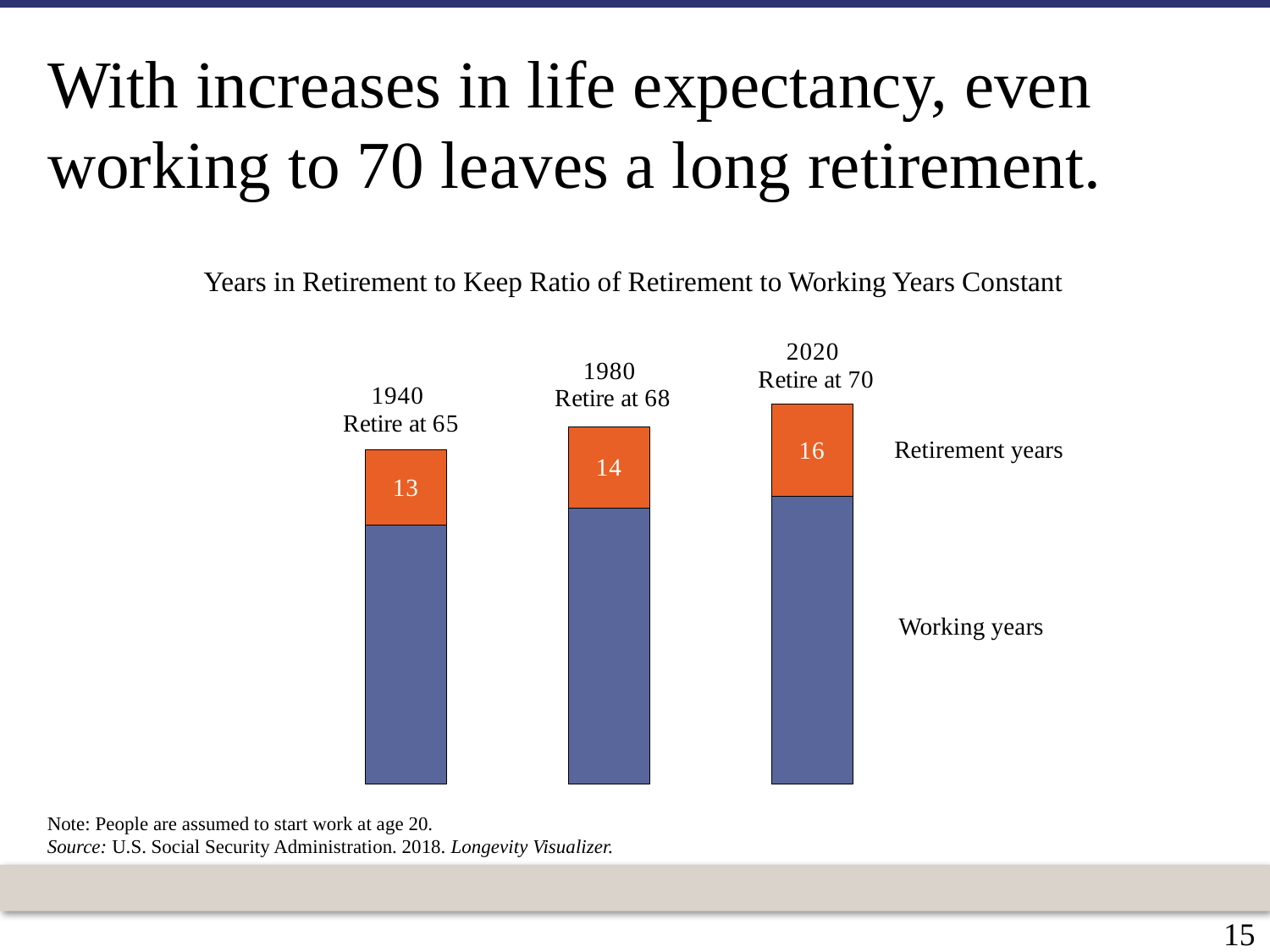
How many series does the chart show? 2 What is the difference in retirement years between 2020 and 1940? 3 How many bars are shown in the chart? 3 Which year has the highest number of retirement years? 2020 Which year has the lowest number of retirement years? 1940 What is the number of retirement years shown for 2020 (Retire at 70)? 16 What is the difference in retirement years between 1980 and 1940? 1 What kind of chart is shown on the slide? Stacked bar chart Do the retirement years rise or fall from 1940 to 2020? Rise Which has more retirement years, 1980 or 2020? 2020 What is the number of retirement years shown for 1980 (Retire at 68)? 14 What is the number of retirement years shown for 1940 (Retire at 65)? 13